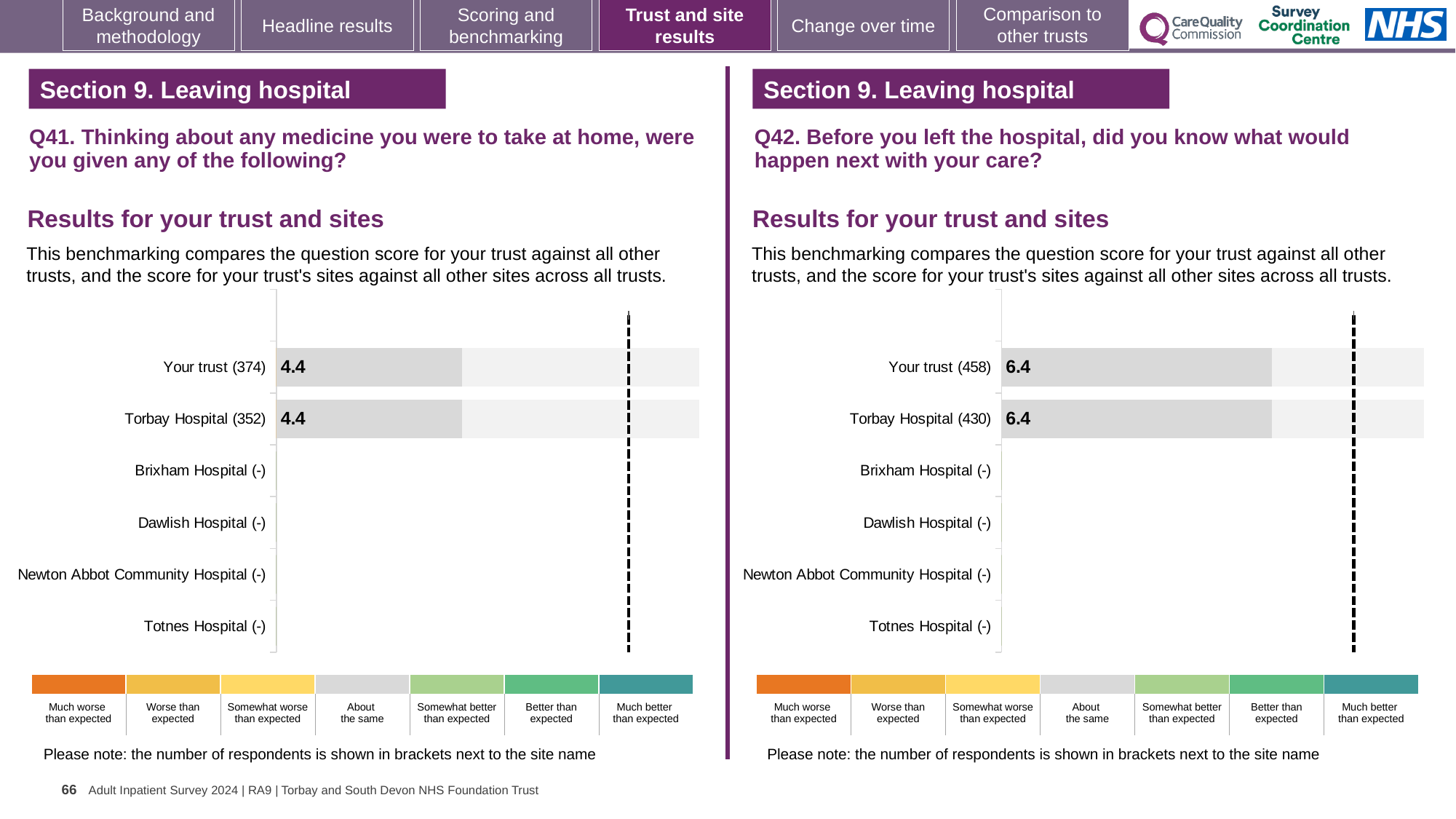
On the Q41 chart (left), how many respondents are shown in brackets for Torbay Hospital? 352 On the Q41 chart (left), what is the difference between the scores for Your trust and Torbay Hospital? 0.0 On the Q42 chart (right), what is the difference between the scores for Your trust and Torbay Hospital? 0.0 On the Q41 chart (left), what is the score for Torbay Hospital (352)? 4.4 On the Q41 chart (left), how many site or trust categories are listed on the vertical axis? 6 On the Q42 chart (right), how many respondents are shown in brackets for Your trust? 458 On the Q42 chart (right), what is the score for Torbay Hospital (430)? 6.4 On the Q42 chart (right), what is the score for Your trust (458)? 6.4 What kind of chart is the Q42 chart (right)? Bar chart How many colour bands does the legend below the Q41 chart (left) show? 7 On the Q41 chart (left), what is the score for Your trust (374)? 4.4 On the Q42 chart (right), how many categories show a plotted bar with a value? 2